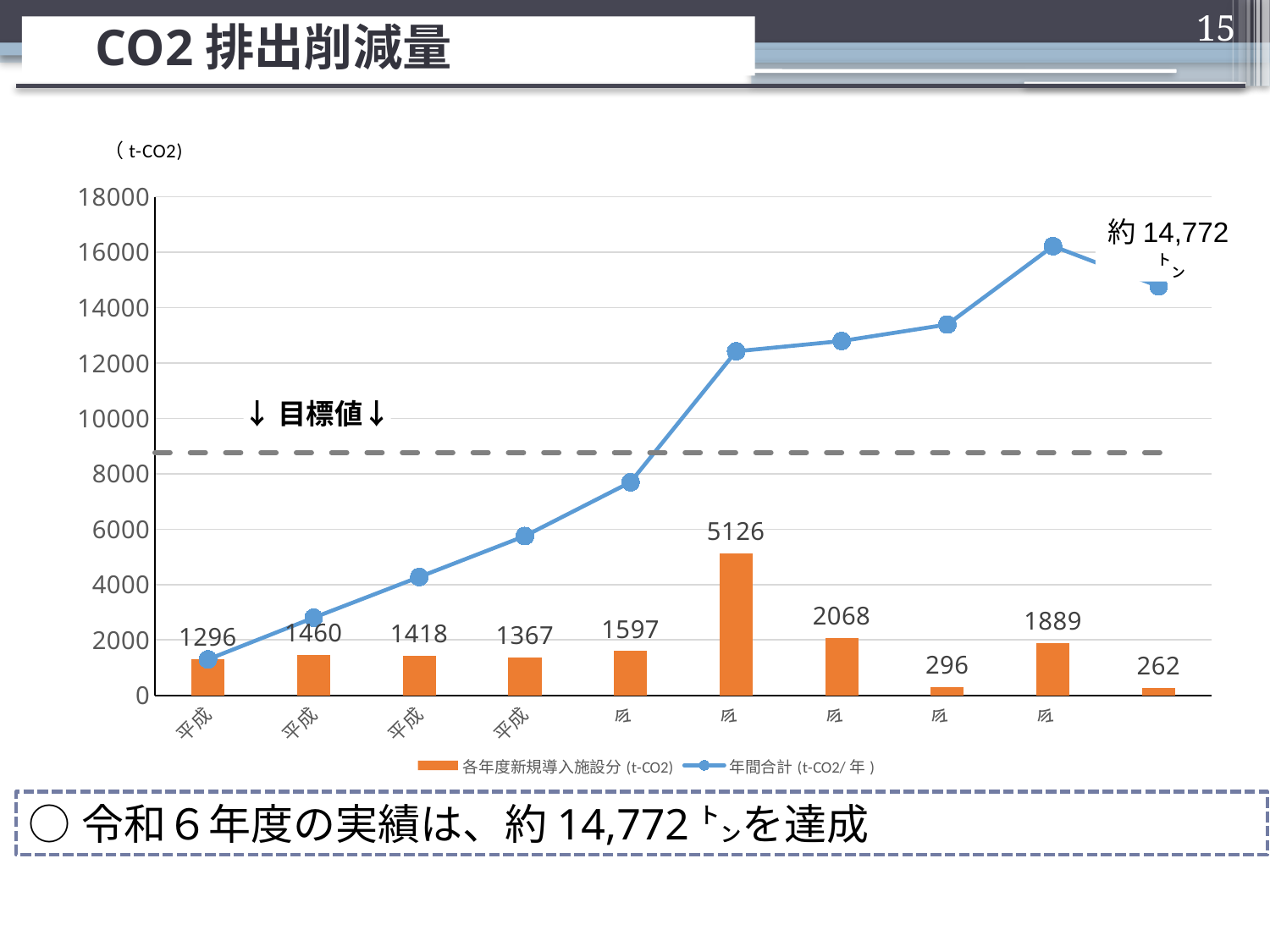
How many series does the legend list? 2 Which orange bar has the highest value? The sixth bar (5126) Is the 年間合計 line value at the fifth category greater or less than 8000? less What is the value of the sixth (tallest) orange bar? 5126 What is the value of the first orange bar on the left? 1296 Does the 年間合計 line generally rise or fall from left to right? Rise What type of chart is shown on the slide? Combined bar and line chart How many orange bars are plotted in the chart? 10 What is the value of the last (rightmost) orange bar? 262 What is the difference between the sixth bar (5126) and the seventh bar (2068)? 3058 Which is larger, the ninth bar (1889) or the eighth bar (296)? The ninth bar (1889) Which orange bar has the lowest value? The last bar (262)